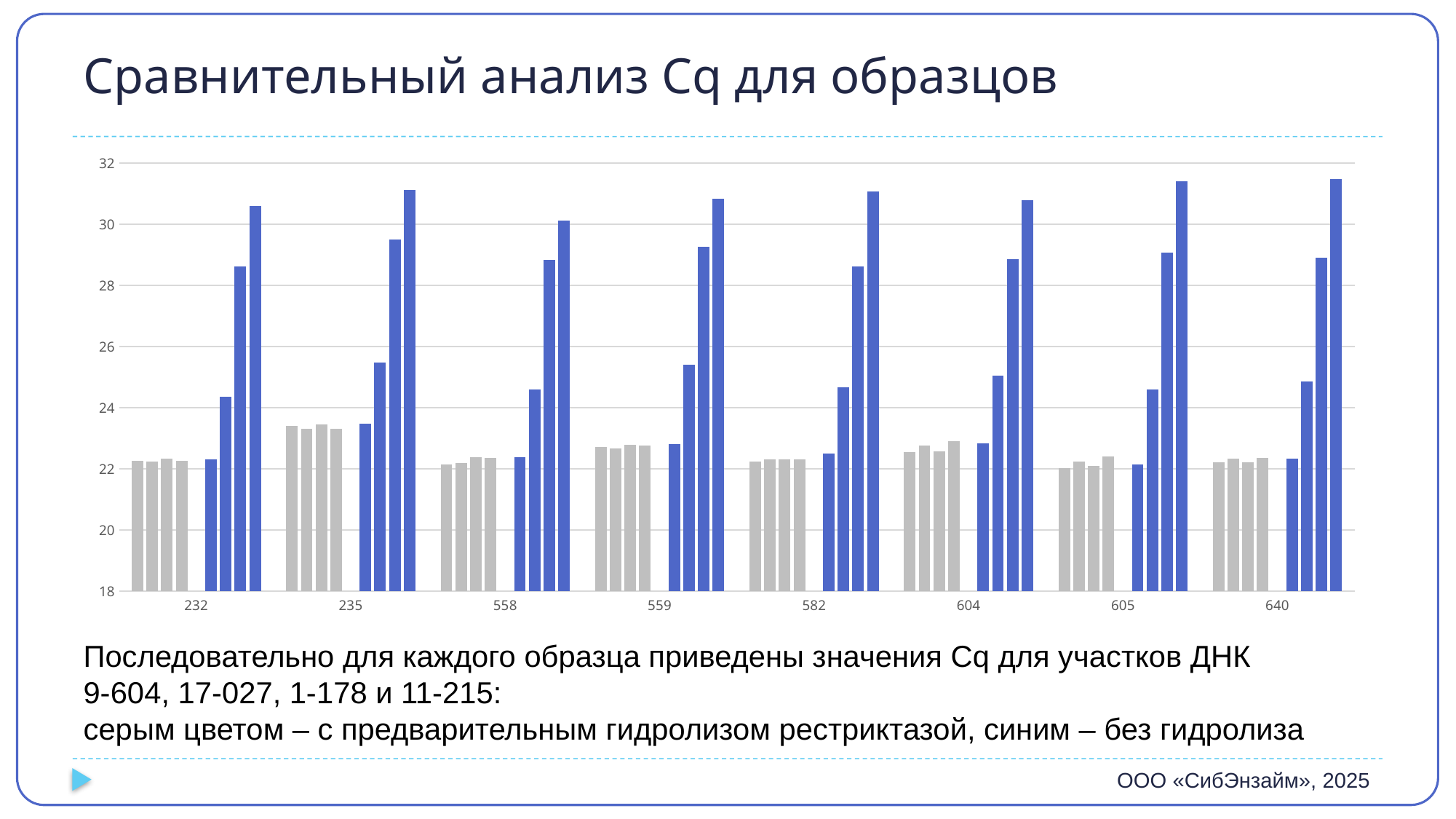
According to the slide text, which colour represents samples without hydrolysis? blue (синим) Within each sample group, do the blue bars rise or fall from left to right? rise For sample 232, which is larger: the fourth blue bar or the first grey bar? the fourth blue bar Is the tallest blue bar for sample 640 greater or less than 30? greater How many sample categories are labelled on the x axis? 8 How many bars are plotted for each sample category? 8 Is the tallest blue bar for sample 605 greater or less than 30? greater For sample 604, which is larger: the first blue bar or the fourth blue bar? the fourth blue bar Is the first blue bar for sample 582 greater or less than 24? less What is the title of the slide? Сравнительный анализ Cq для образцов What kind of chart is shown on the slide? bar chart